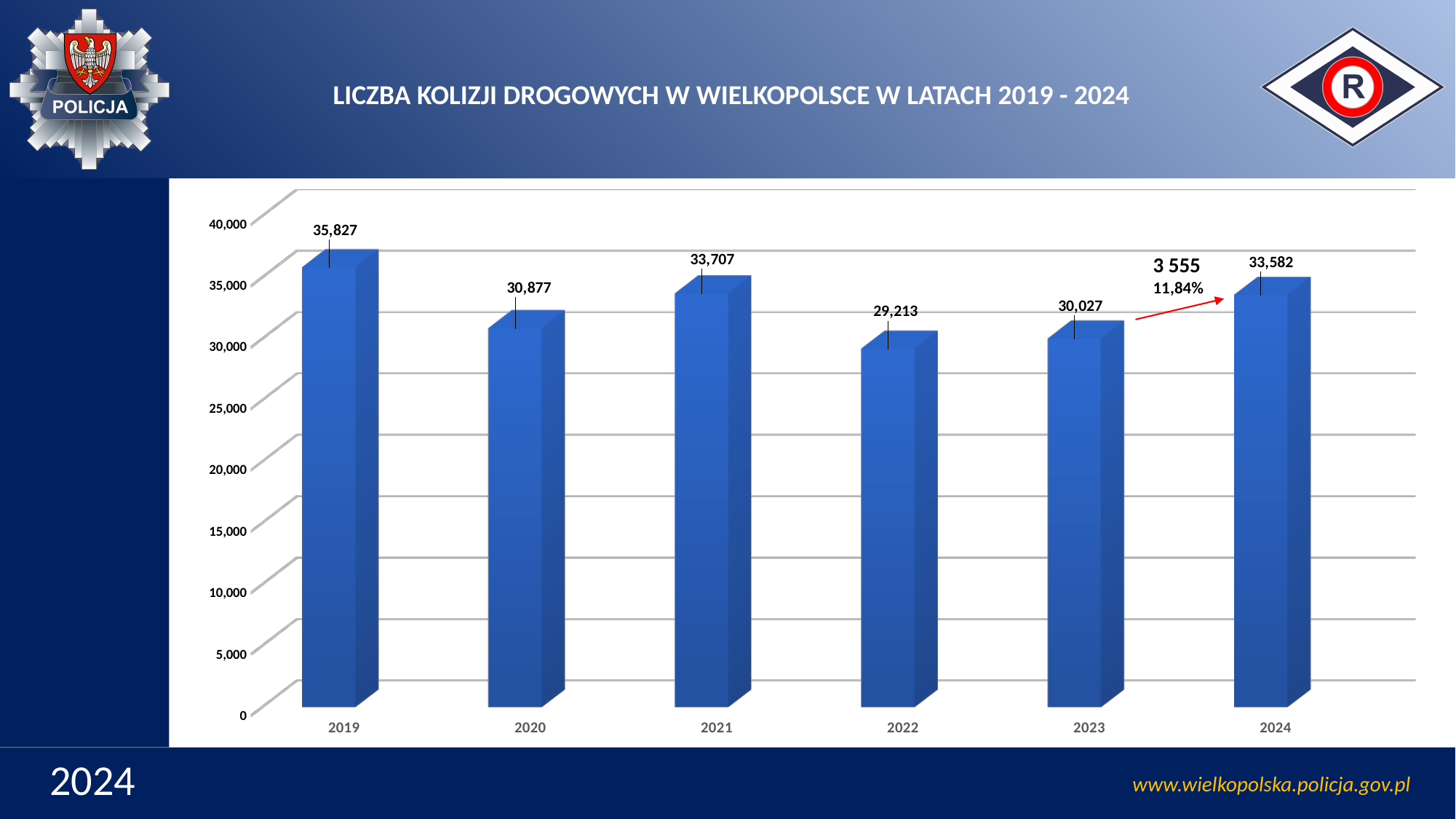
What value is shown for 2024? 33,582 What is the difference between the values for 2019 and 2020? 4,950 Which is larger, the value for 2021 or the value for 2024? 2021 What is the number of road collisions shown for 2019? 35,827 Which year has the highest value? 2019 How many years are shown on the x axis? 6 What percentage change is annotated between 2023 and 2024? 11,84% What value is shown for 2022? 29,213 Is the value for 2020 greater or less than 35,000? less What kind of chart is shown on the slide? bar chart What is the difference between the values for 2024 and 2023? 3,555 Which year has the lowest value? 2022